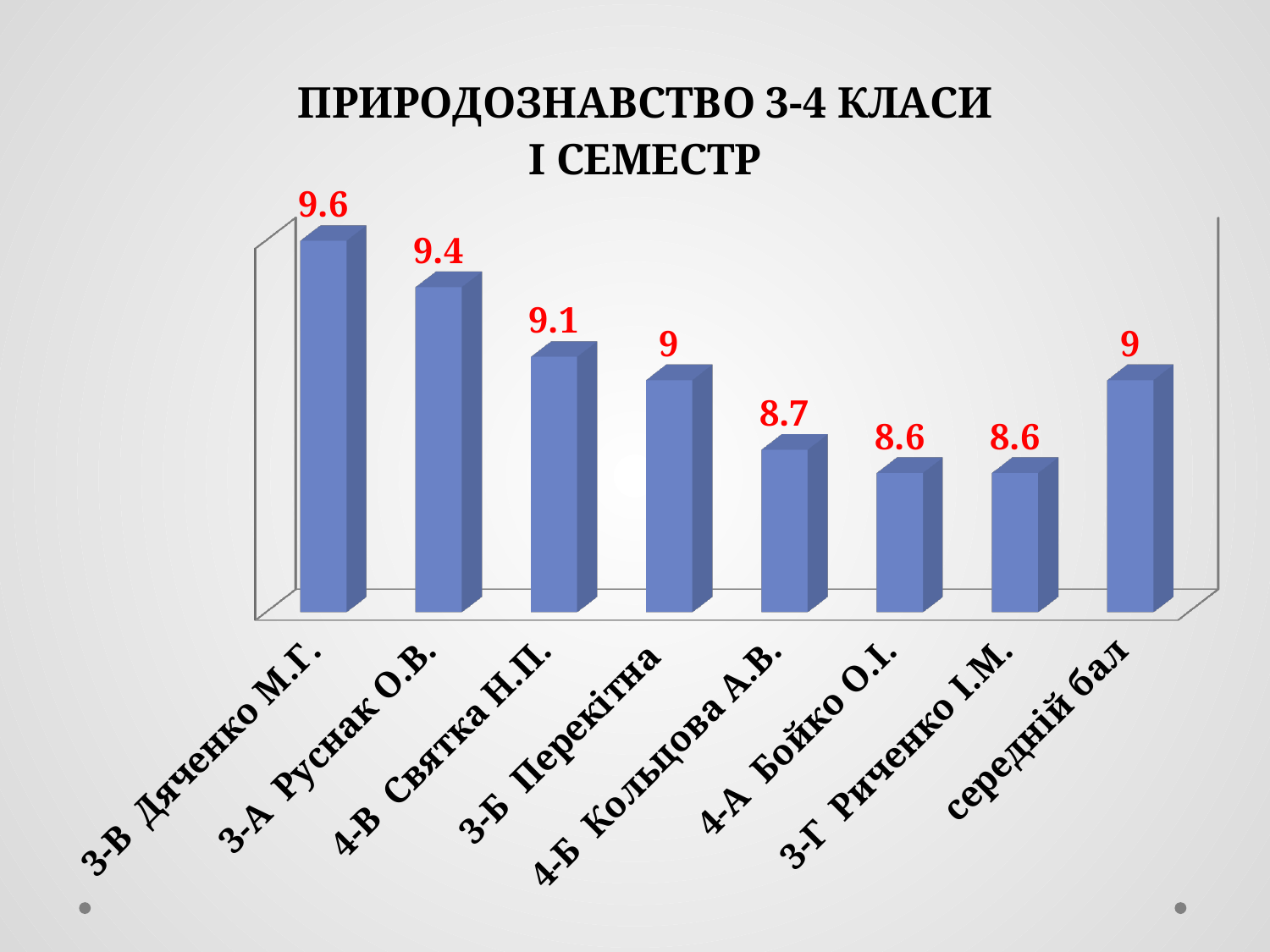
Do the values rise or fall from 3-В Дяченко М.Г. to 3-Г Риченко І.М.? fall How many bars are shown in the chart? 8 What is the difference between the values for 3-Б Перекітна and 4-А Бойко О.І.? 0.4 What is the title of the chart? ПРИРОДОЗНАВСТВО 3-4 КЛАСИ І СЕМЕСТР What is the value for 3-В Дяченко М.Г.? 9.6 What is the value for 4-В Святка Н.П.? 9.1 What is the value for середній бал? 9 What kind of chart is shown on the slide? bar chart What is the value for 4-Б Кольцова А.В.? 8.7 What is the difference between the values for 3-В Дяченко М.Г. and 3-А Руснак О.В.? 0.2 Which category has the highest value? 3-В Дяченко М.Г. Which is larger, the value for 3-А Руснак О.В. or the value for 4-Б Кольцова А.В.? 3-А Руснак О.В.